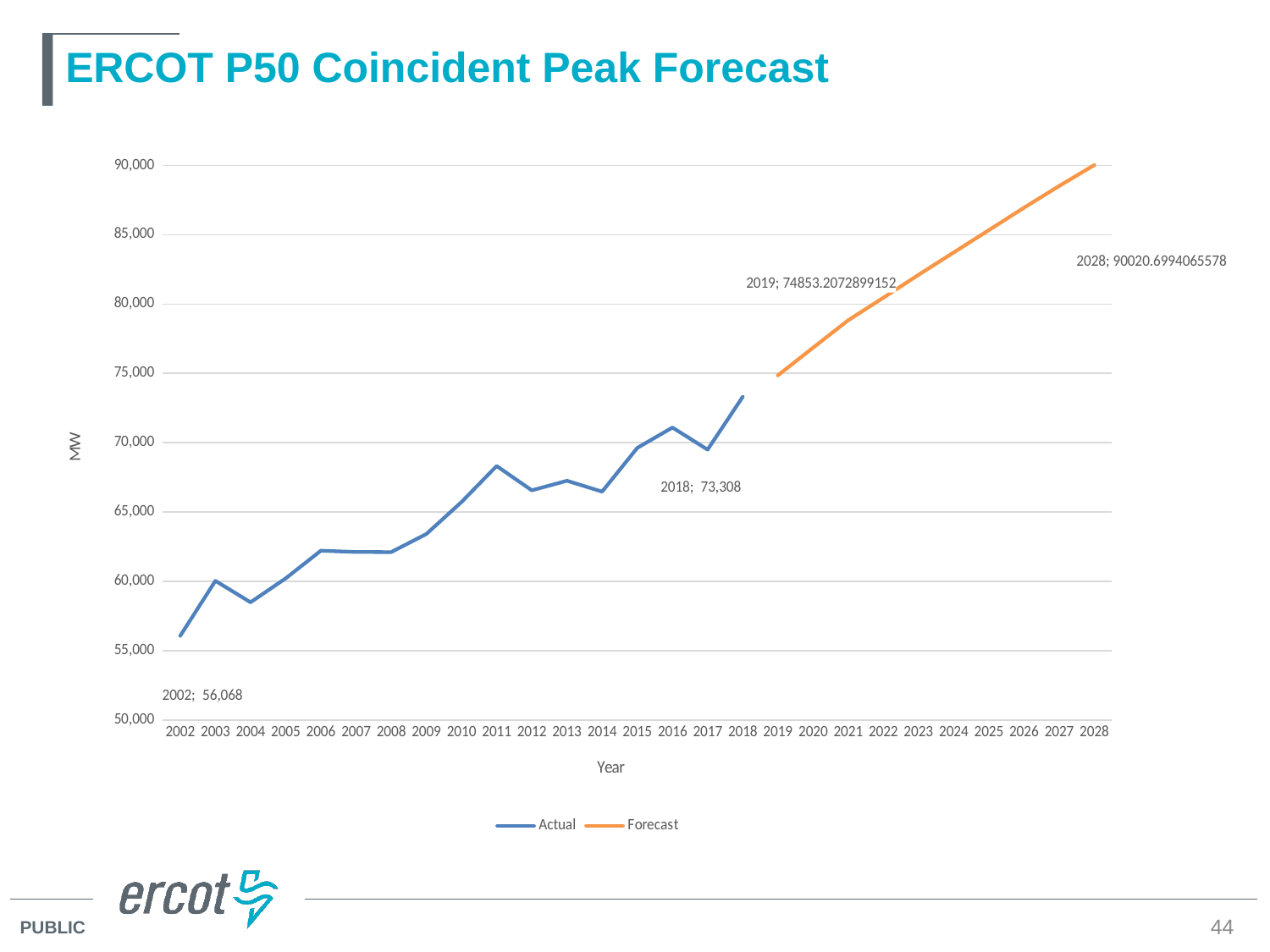
What is the label on the y axis? MW What is the Actual value for 2018? 73,308 Is the Actual value for 2011 greater or less than 65,000? greater What is the Forecast value for 2019? 74853.2072899152 Which year has the lowest Actual value? 2002 Is the Actual value for 2004 greater or less than 60,000? less Does the Forecast series rise or fall from 2019 to 2028? Rise What is the Actual value for 2002? 56,068 What kind of chart is shown on the slide? Line chart How many series does the legend list? 2 What is the Forecast value for 2028? 90020.6994065578 What is the difference between the Actual values for 2018 and 2002? 17,240